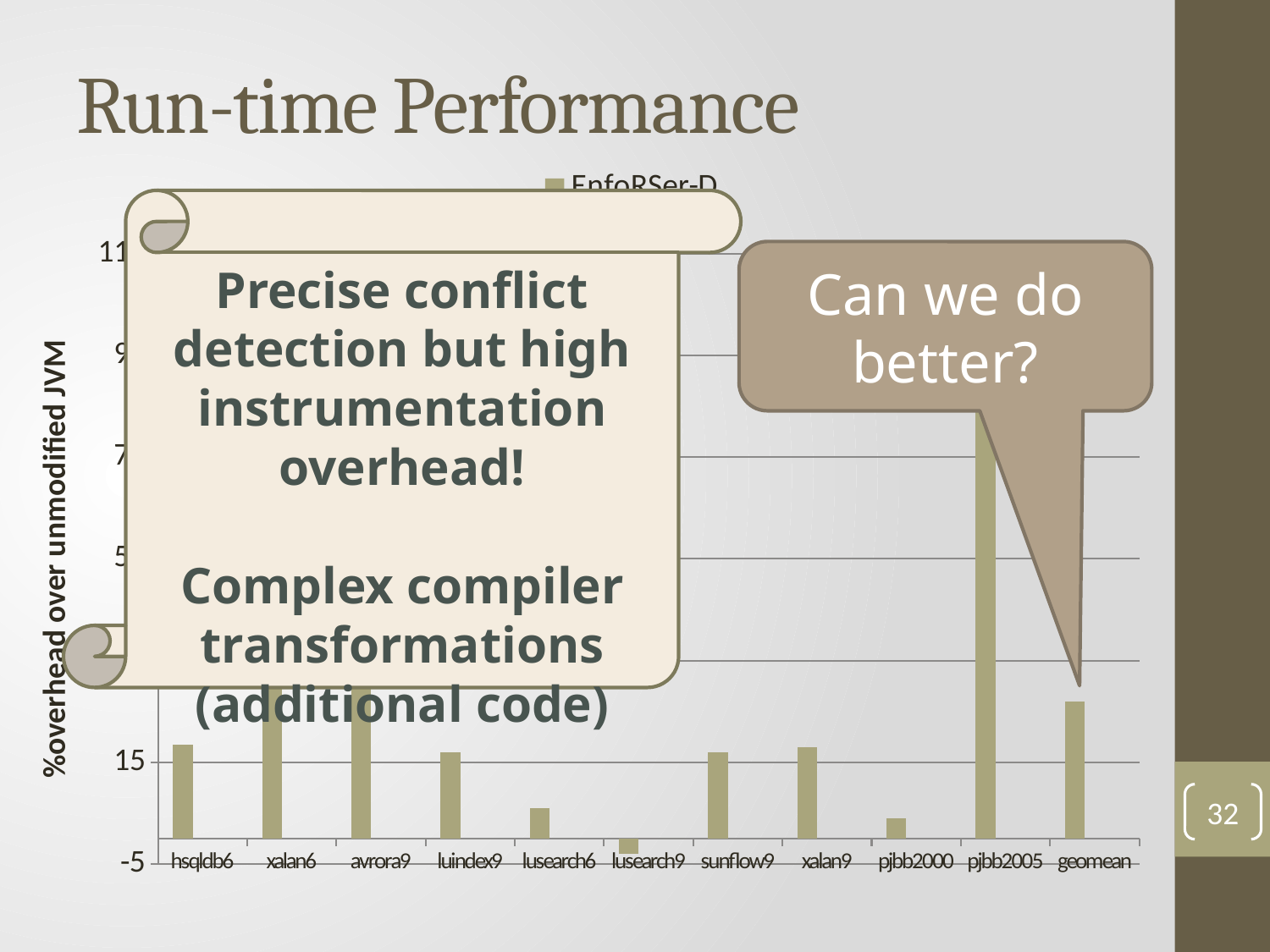
Is the value for geomean greater or less than 15? greater What kind of chart is shown on the slide? bar chart Which category has the highest bar in the chart? pjbb2005 Which has the larger value, geomean or hsqldb6? geomean Is the value for pjbb2005 greater or less than 15? greater What is the label of the y axis of the chart? %overhead over unmodified JVM Is the value for pjbb2000 greater or less than 15? less Which has the larger value, pjbb2005 or geomean? pjbb2005 Which category has the lowest bar in the chart? lusearch9 How many benchmark categories are shown on the x axis of the chart? 11